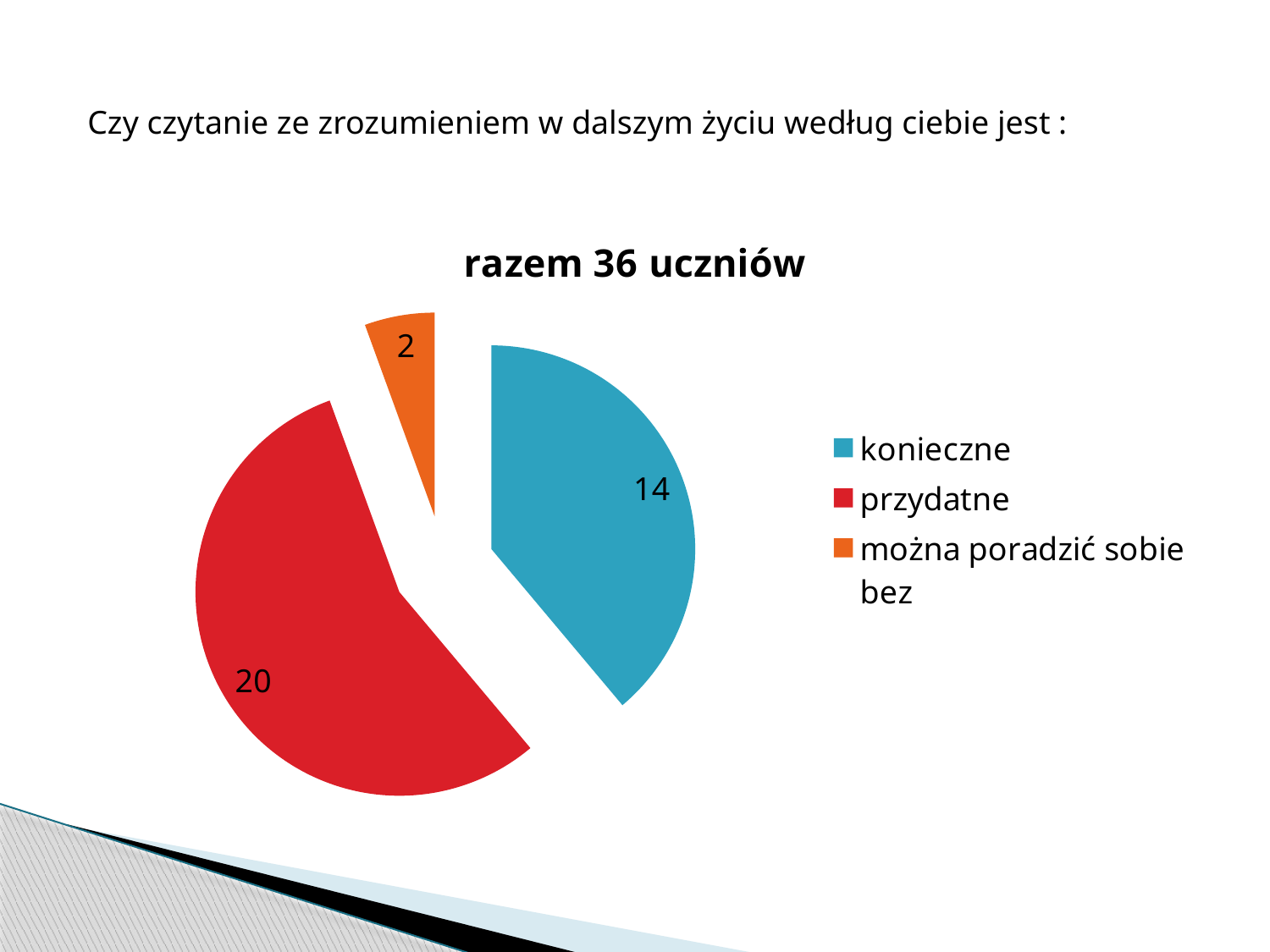
How many slices does the pie chart have? 3 What type of chart is shown on the slide? pie chart What is the difference between the values for "przydatne" and "konieczne"? 6 What is the total of all slices in the pie chart? 36 Which is larger, the value for "konieczne" or the value for "można poradzić sobie bez"? konieczne What is the value for "można poradzić sobie bez"? 2 What is the value for "przydatne"? 20 Which category has the largest slice? przydatne Which category has the smallest slice? można poradzić sobie bez What is the title of the chart? razem 36 uczniów What is the value for "konieczne"? 14 What colour is the slice for "przydatne"? red